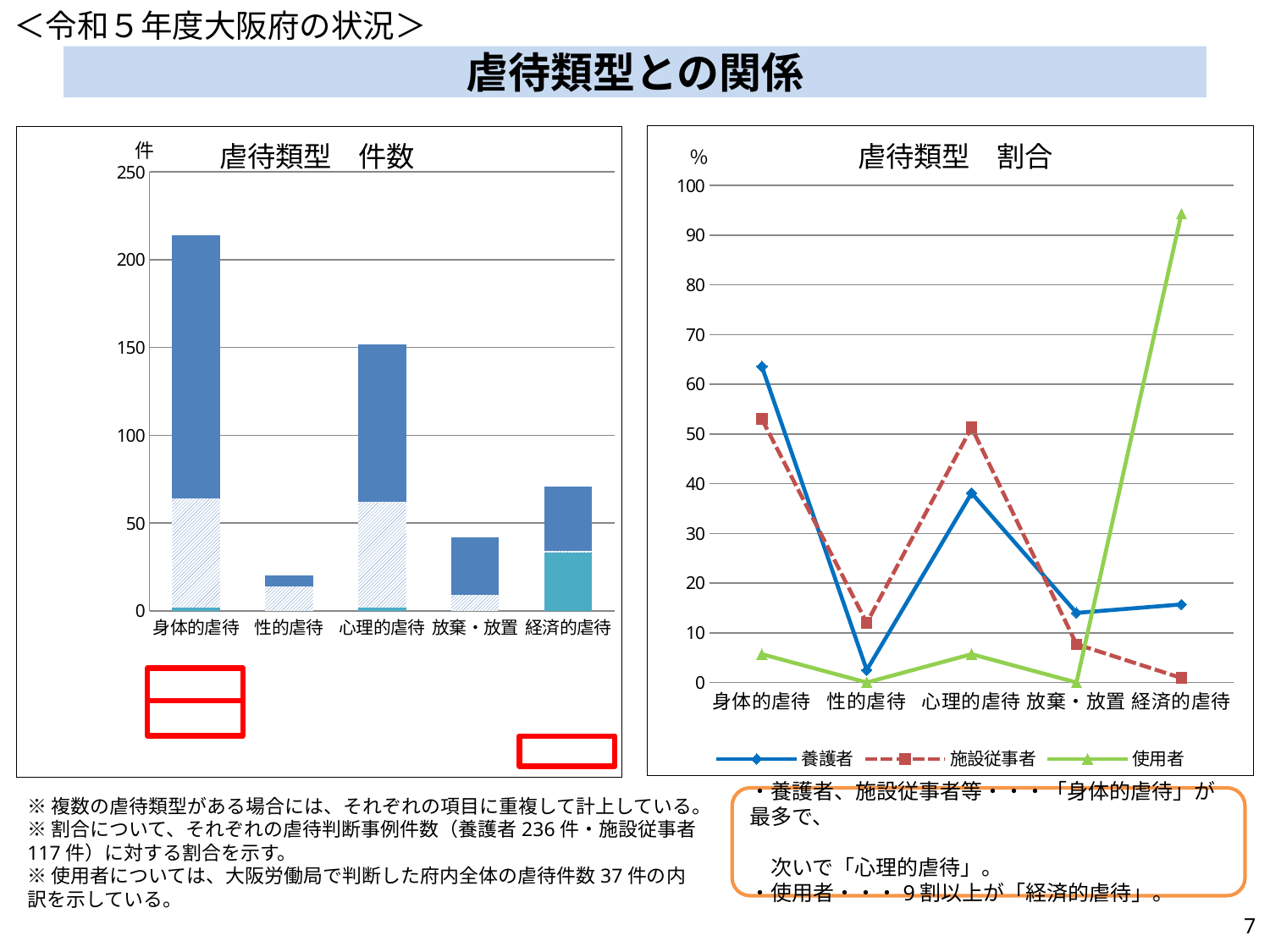
In the right chart 虐待類型 割合, which series is drawn with a dashed line? 施設従事者 How many series does the legend of the right chart 虐待類型 割合 list? 3 In the right chart 虐待類型 割合, for 心理的虐待, which series has the larger value: 養護者 or 施設従事者? 施設従事者 In the right chart 虐待類型 割合, is the value of 使用者 for 経済的虐待 greater or less than 90? greater In the left chart 虐待類型 件数, which category has the tallest bar? 身体的虐待 In the left chart 虐待類型 件数, is the total bar height for 身体的虐待 greater or less than 200? greater In the left chart 虐待類型 件数, is the total bar height for 放棄・放置 greater or less than 50? less What kind of chart is the left chart titled 虐待類型 件数? bar chart How many categories are shown on the x axis of the left chart 虐待類型 件数? 5 What kind of chart is the right chart titled 虐待類型 割合? line chart In the right chart 虐待類型 割合, which category has the highest value for the 養護者 series? 身体的虐待 In the left chart 虐待類型 件数, which category has the shortest bar? 性的虐待